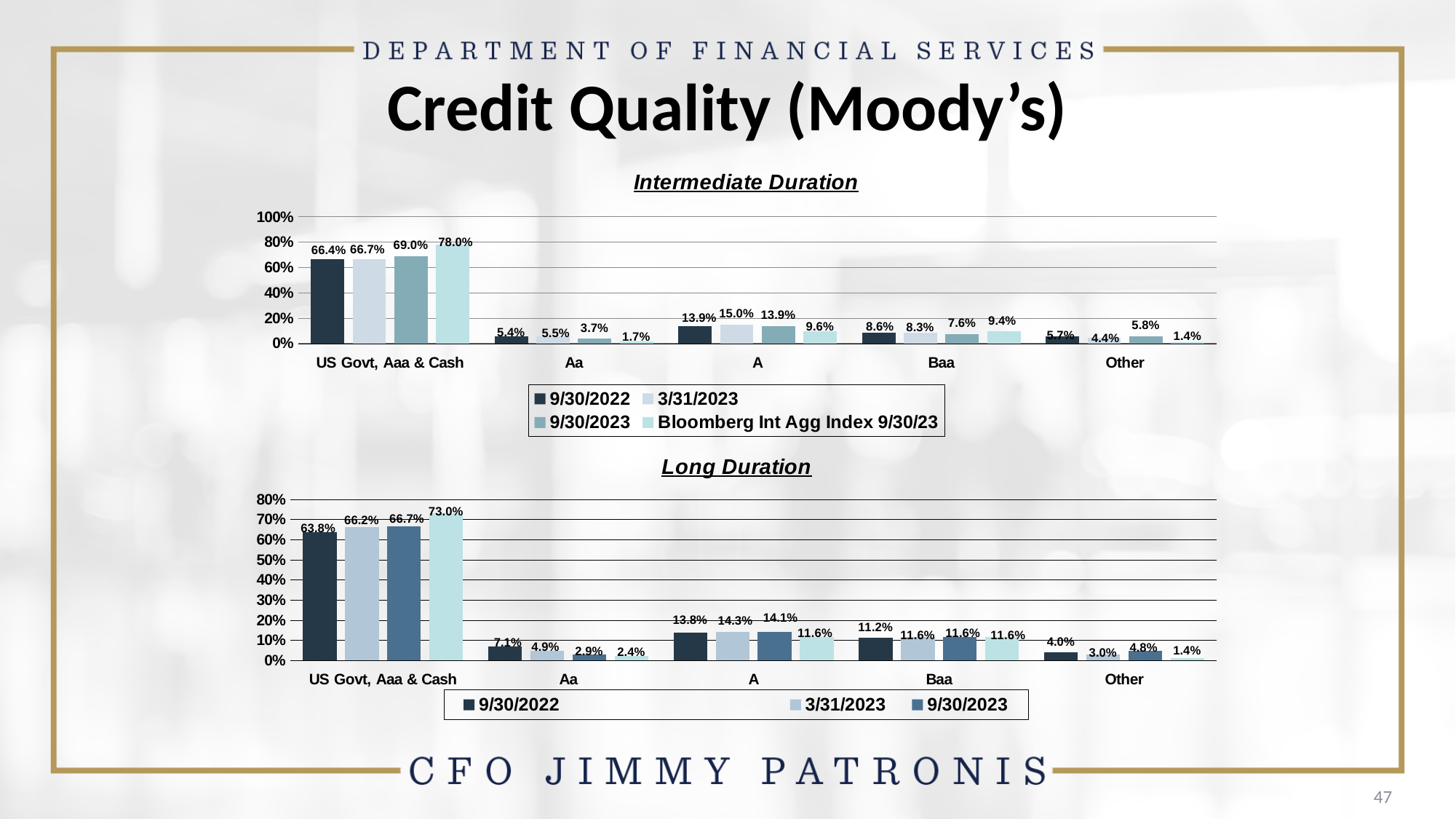
What type of chart is the Intermediate Duration chart? Bar chart In the Intermediate Duration chart, what is the value for Aa for the Bloomberg Int Agg Index 9/30/23 series? 1.7% In the Long Duration chart, what is the value for Aa for the 9/30/2023 series? 2.9% In the Long Duration chart, which is larger for the A category: the 3/31/2023 value or the 9/30/2022 value? 3/31/2023 How many categories are shown on the x axis of the Long Duration chart? 5 In the Intermediate Duration chart, which category has the highest value for the 9/30/2022 series? US Govt, Aaa & Cash In the Intermediate Duration chart, what is the value for Baa for the 3/31/2023 series? 8.3% In the Intermediate Duration chart, what is the value for US Govt, Aaa & Cash for the 9/30/2023 series? 69.0% In the Long Duration chart, which category has the lowest value for the 3/31/2023 series? Other In the Intermediate Duration chart, what is the difference between the 9/30/2023 value and the 9/30/2022 value for US Govt, Aaa & Cash? 2.6% In the Long Duration chart, what is the value for US Govt, Aaa & Cash for the 9/30/2022 series? 63.8% In the Intermediate Duration chart, how many series does the legend list? 4